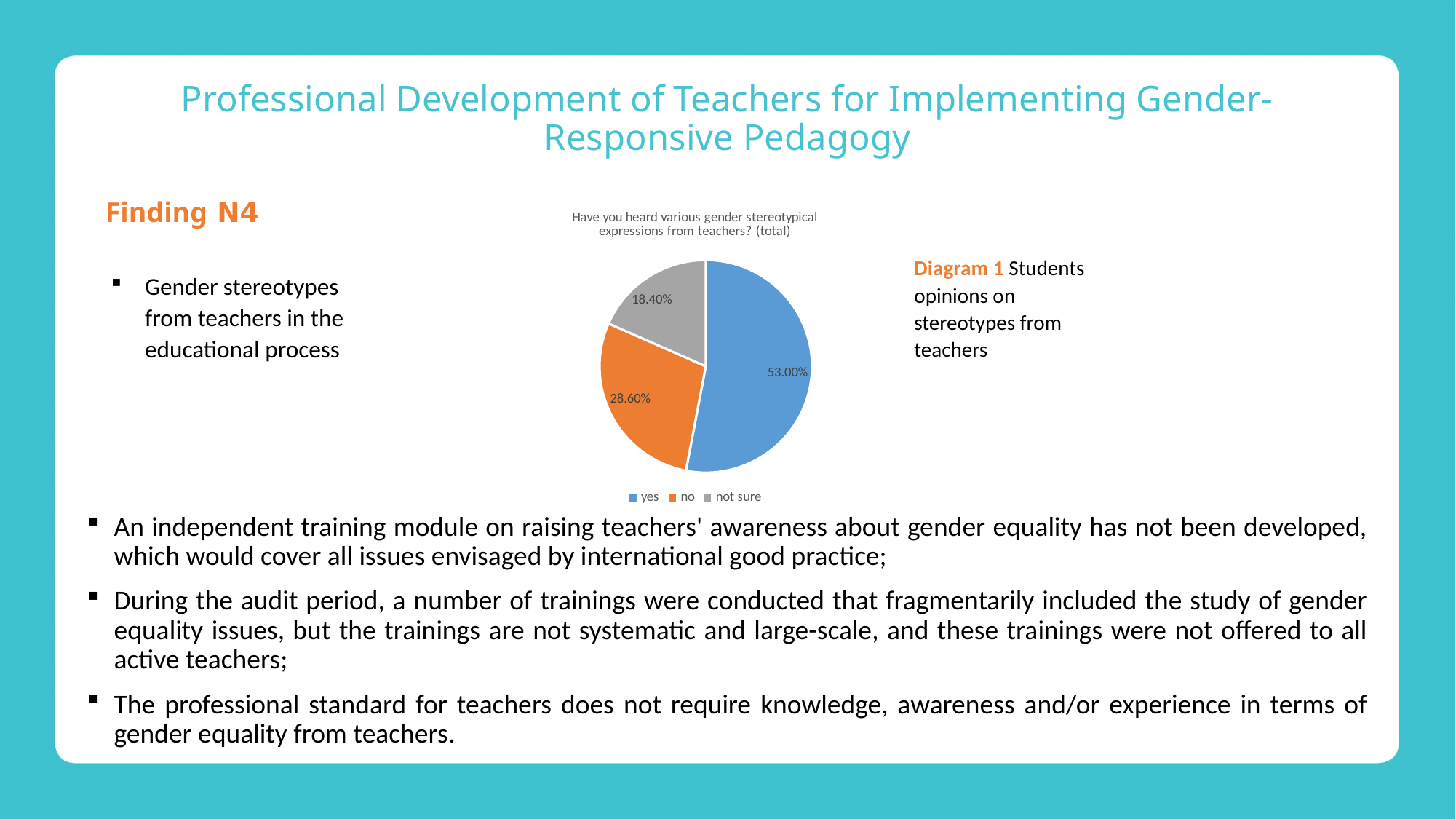
What is the difference in percentage points between the "yes" and "no" shares? 24.40% What share of students answered "no"? 28.60% Which response has the largest share of the pie? yes Which response has the smallest share of the pie? not sure Which is larger, the share for "no" or the share for "not sure"? no What share of students answered "not sure"? 18.40% What type of chart is shown on the slide? pie chart What share of students answered "yes"? 53.00% What is the chart's title? Have you heard various gender stereotypical expressions from teachers? (total) How many entries does the legend list? 3 What colour is the "not sure" slice? grey How many slices does the pie chart have? 3